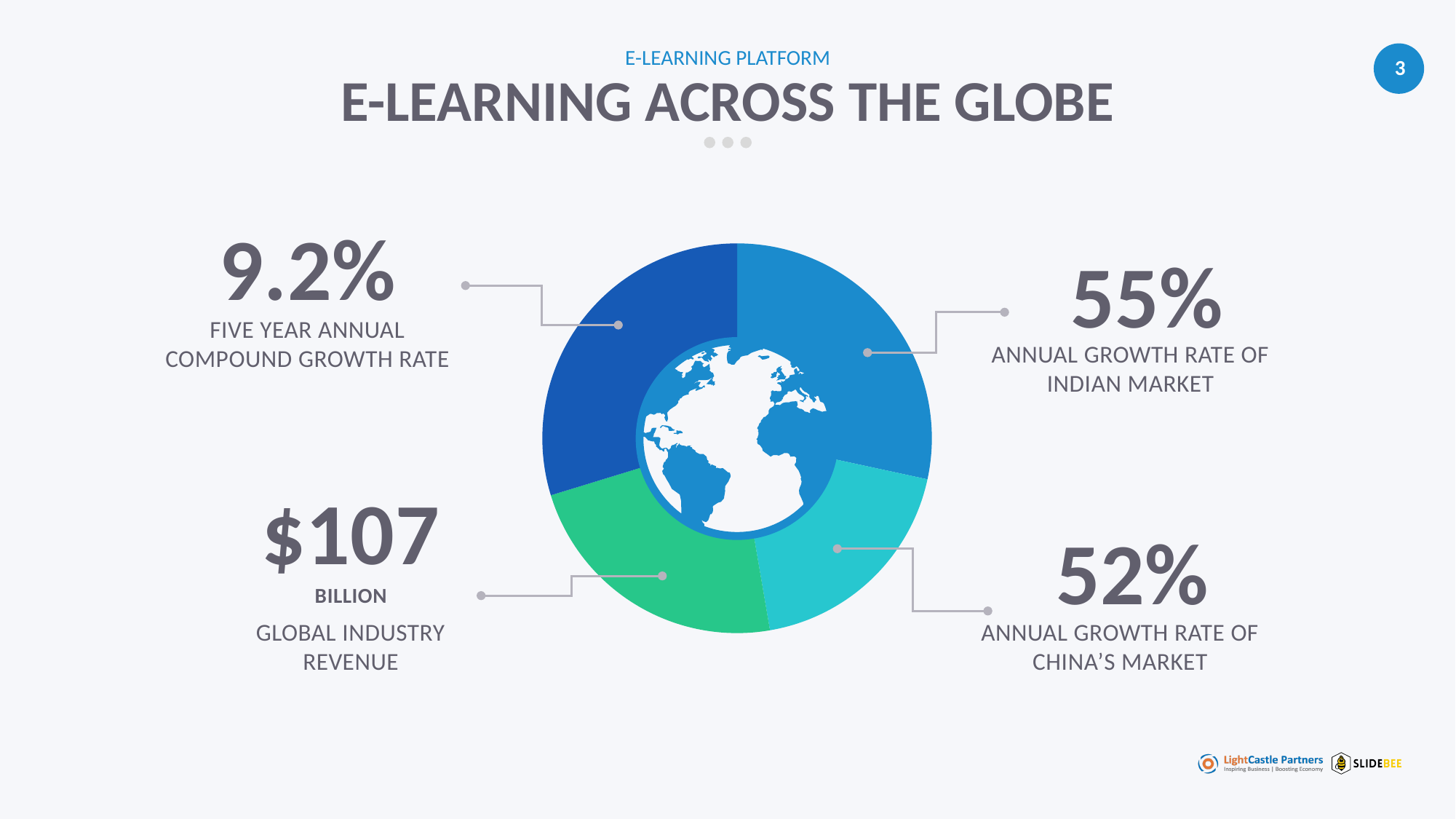
What is the annual growth rate of the Indian market shown on the chart? 55% Which of the three growth rates shown on the chart is the lowest? Five year annual compound growth rate (9.2%) What colour is the segment linked to the $107 billion global industry revenue figure? Green What kind of chart is shown on the slide? Donut (pie) chart What is the annual growth rate of China's market shown on the chart? 52% Which of the three growth rates shown on the chart is the highest? Annual growth rate of Indian market (55%) What is the global industry revenue shown on the chart? $107 billion What is the five year annual compound growth rate shown on the chart? 9.2% What is the difference between the annual growth rate of the Indian market and that of China's market? 3% How many segments does the donut chart have? 4 Which market has the higher annual growth rate, India or China? India What is the title of the slide containing the chart? E-Learning Across the Globe